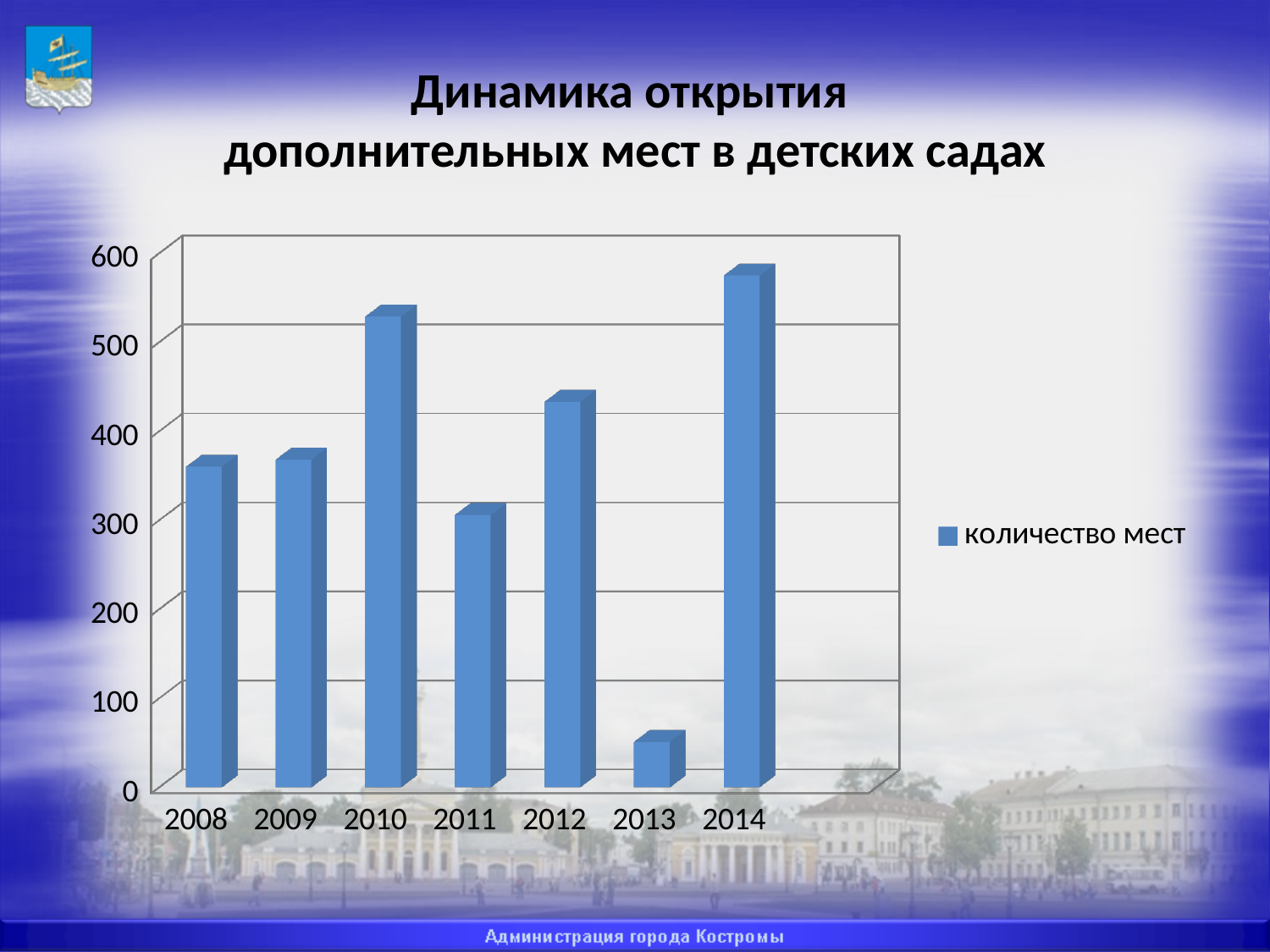
How many years are shown on the x axis of the chart? 7 Which year has the larger value, 2011 or 2012? 2012 Is the value for 2014 greater or less than 500? greater Does the value rise or fall from 2013 to 2014? rise What kind of chart is shown on the slide? bar chart Which year has the larger value, 2010 or 2012? 2010 Which year has the highest number of places? 2014 How many series does the chart legend list? 1 Is the value for 2011 greater or less than 400? less Which year has the lowest number of places? 2013 What is the name of the series shown in the legend? количество мест Is the value for 2013 greater or less than 100? less